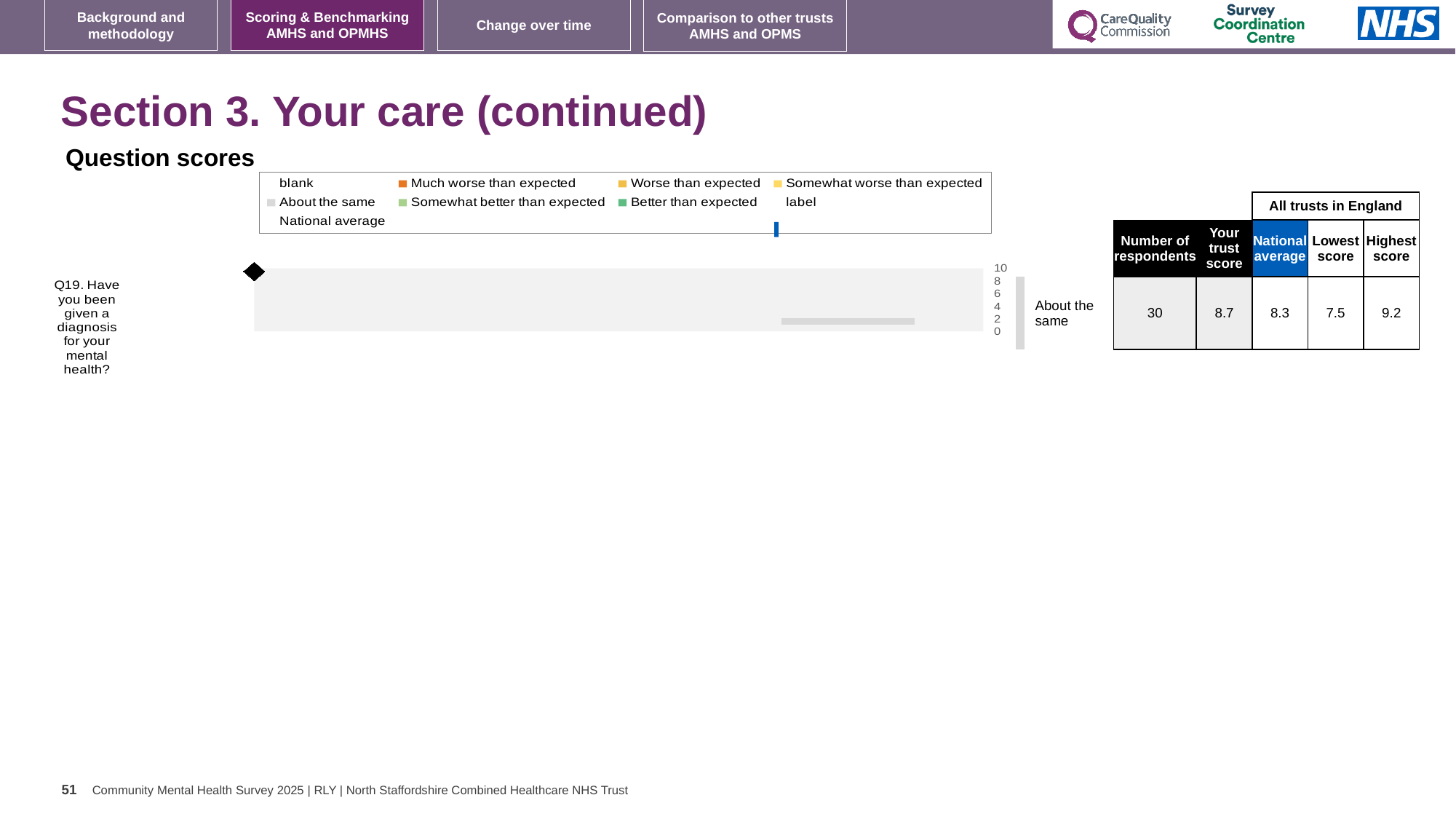
What benchmark category is shown for Q19 on the Question scores chart? About the same What is the highest score across all trusts in England for Q19? 9.2 What is the national average score for Q19 shown alongside the Question scores chart? 8.3 What kind of chart is the Question scores chart? Bar chart Which question is plotted on the Question scores chart? Q19. Have you been given a diagnosis for your mental health? For Q19, which is larger: the trust score or the national average? Trust score How many respondents answered Q19? 30 What is the difference between the highest and lowest scores for Q19 across all trusts in England? 1.7 What is the lowest score across all trusts in England for Q19? 7.5 What is the trust score for Q19 shown alongside the Question scores chart? 8.7 How many questions are plotted on the Question scores chart? 1 By how much does the trust score for Q19 exceed the national average? 0.4